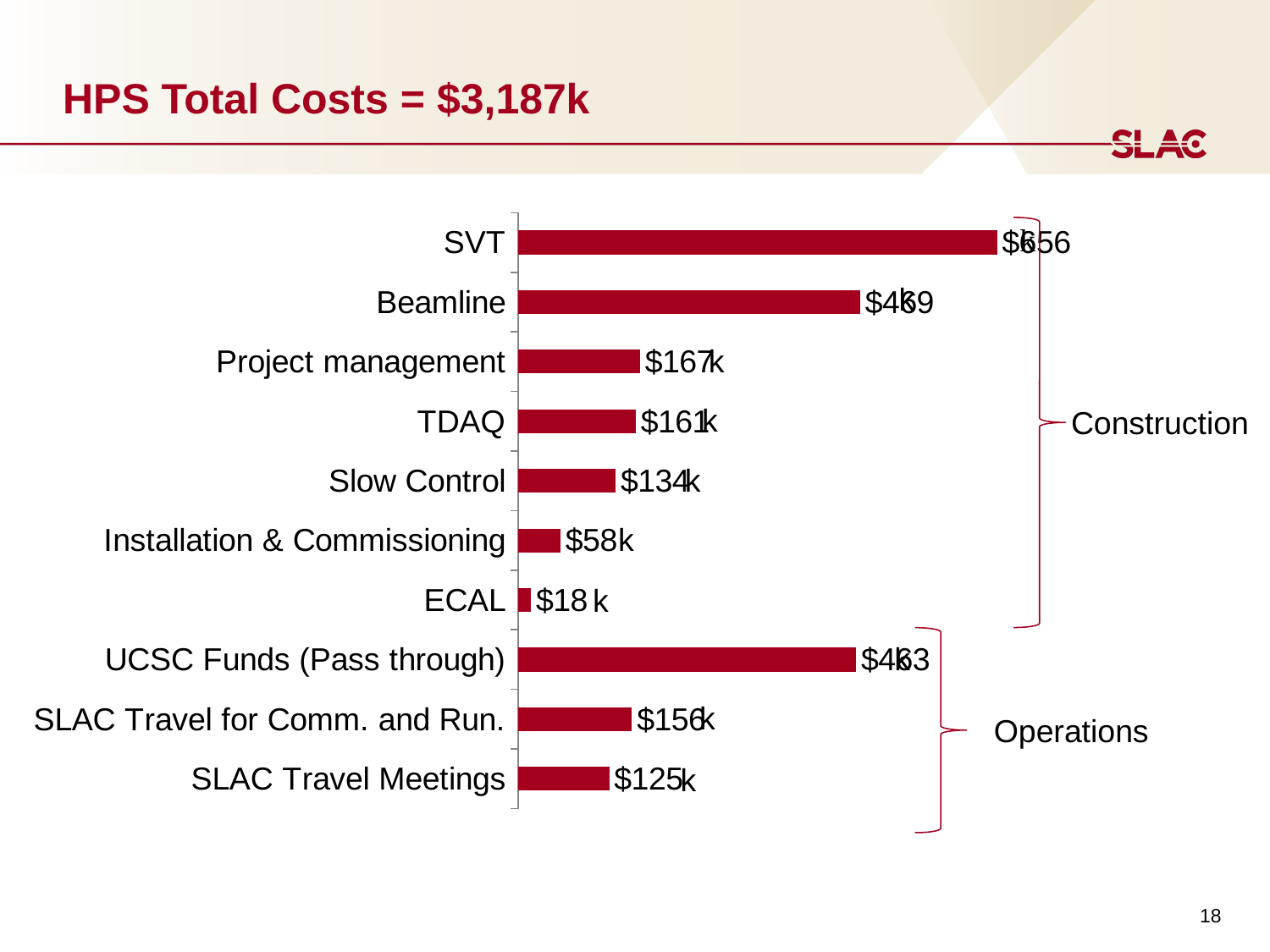
What is the cost shown for Installation & Commissioning? $58k Which is larger, the cost for SVT or the cost for Beamline? SVT Which category has the lowest cost? ECAL What kind of chart is shown on the slide? bar chart What is the cost shown for ECAL? $18k What are the two group labels shown to the right of the bars? Construction and Operations Which category has the highest cost? SVT What is the difference between the Project management cost and the TDAQ cost? $6k What is the difference between the Slow Control cost and the Installation & Commissioning cost? $76k What is the cost shown for Slow Control? $134k How many categories are plotted in the chart? 10 What is the cost shown for SLAC Travel Meetings? $125k